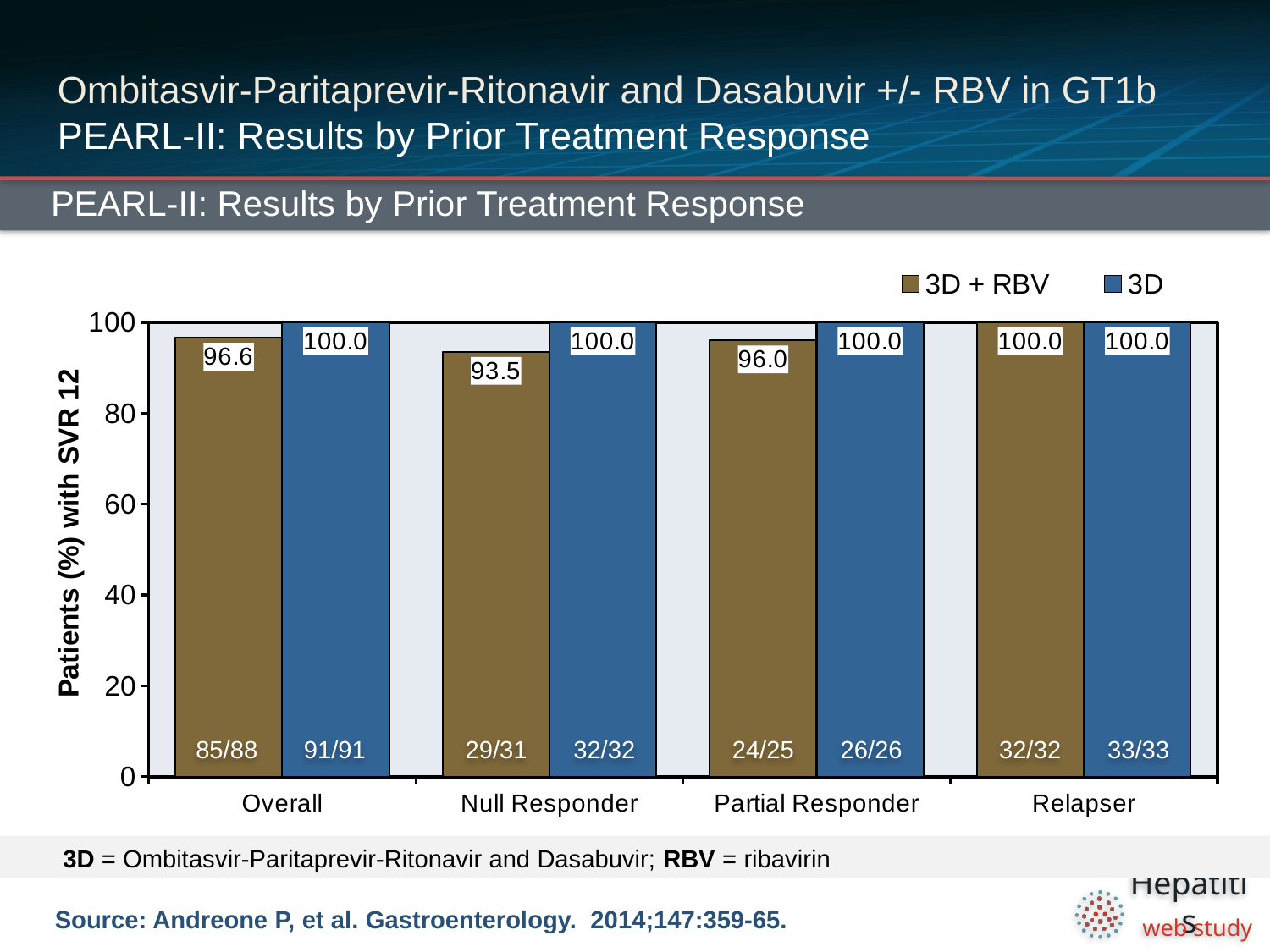
How many prior treatment response categories are shown on the x axis? 4 What is the SVR 12 rate for the 3D + RBV group among Null Responders? 93.5 What is the label of the y axis? Patients (%) with SVR 12 What is the patient fraction shown for the 3D + RBV group among Partial Responders? 24/25 What is the difference between the 3D and 3D + RBV SVR 12 rates among Null Responders? 6.5 What is the patient fraction shown for the 3D group in the Overall category? 91/91 What kind of chart is shown on the slide? Bar chart How many series does the legend list? 2 Which category has the lowest SVR 12 rate for the 3D + RBV group? Null Responder Which group has the higher SVR 12 rate among Partial Responders, 3D + RBV or 3D? 3D What is the SVR 12 rate for the 3D group among Partial Responders? 100.0 What is the SVR 12 rate for the 3D + RBV group in the Overall category? 96.6